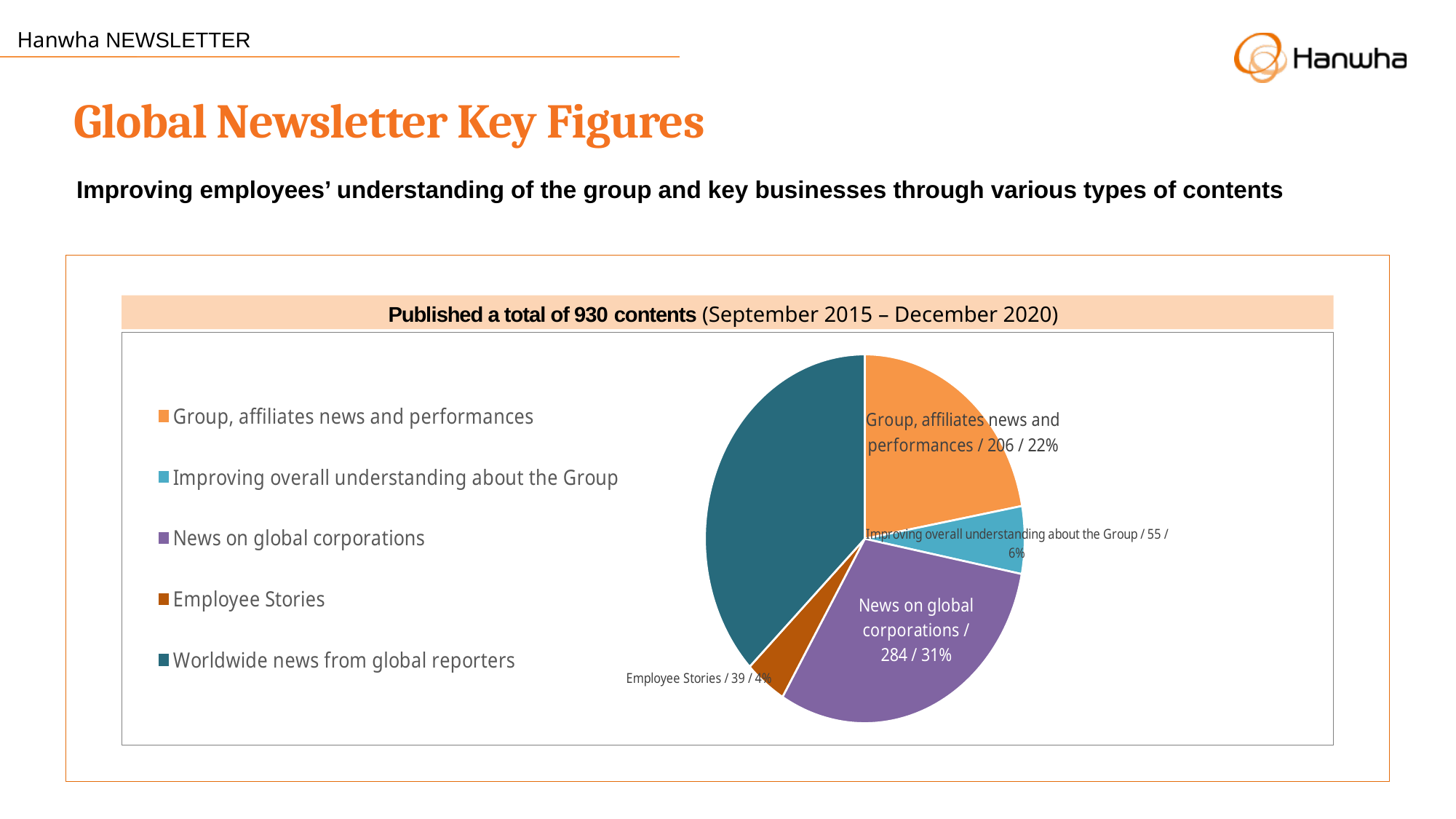
How many contents are in the 'Employee Stories' category? 39 What total number of contents does the chart header say were published? 930 How many contents are in the 'Group, affiliates news and performances' category? 206 What share of the pie does 'Improving overall understanding about the Group' represent? 6% Which has more contents: 'Improving overall understanding about the Group' or 'Employee Stories'? Improving overall understanding about the Group How many categories does the pie chart have? 5 What share of the pie does 'News on global corporations' represent? 31% Which category has the smallest slice of the pie? Employee Stories What type of chart is shown on the slide? pie chart Which category has the largest slice of the pie? Worldwide news from global reporters What is the difference in number of contents between 'News on global corporations' and 'Group, affiliates news and performances'? 78 How many contents are in the 'News on global corporations' category? 284